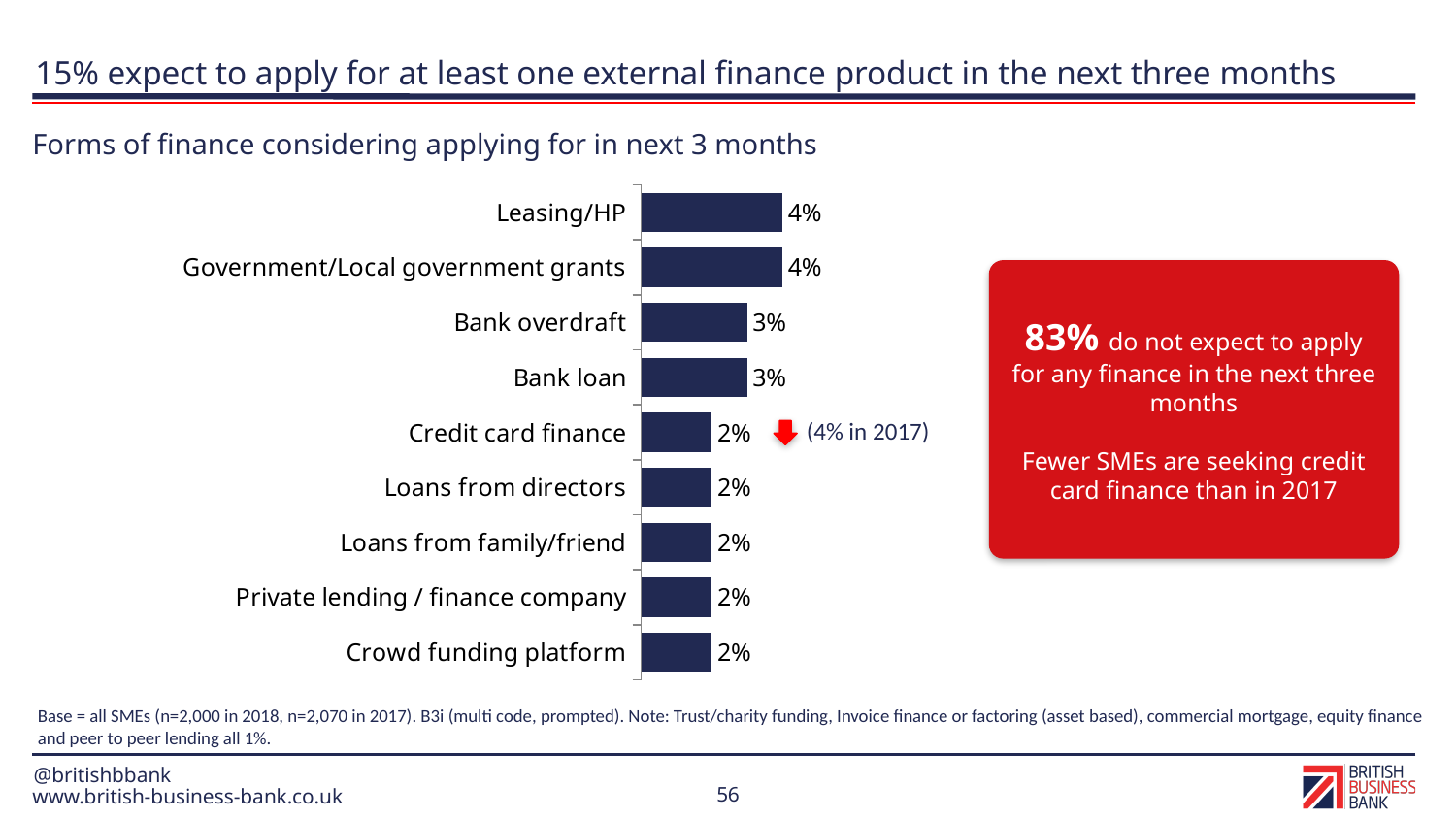
Do the values rise or fall going down the list of categories from Leasing/HP to Crowd funding platform? Fall What is the value shown for Crowd funding platform? 2% What is the difference between the value for Leasing/HP and the value for Bank loan? 1% What percentage of SMEs are considering applying for Leasing/HP in the next 3 months? 4% What was the value for Credit card finance in 2017, as noted on the chart? 4% What is the title of the chart? Forms of finance considering applying for in next 3 months Which is larger, the value for Government/Local government grants or the value for Loans from directors? Government/Local government grants What is the value shown for Credit card finance? 2% How many forms of finance are listed in the chart? 9 According to the red box, what percentage do not expect to apply for any finance in the next three months? 83% What is the value shown for Bank overdraft? 3% What type of chart is used to show the forms of finance? Bar chart